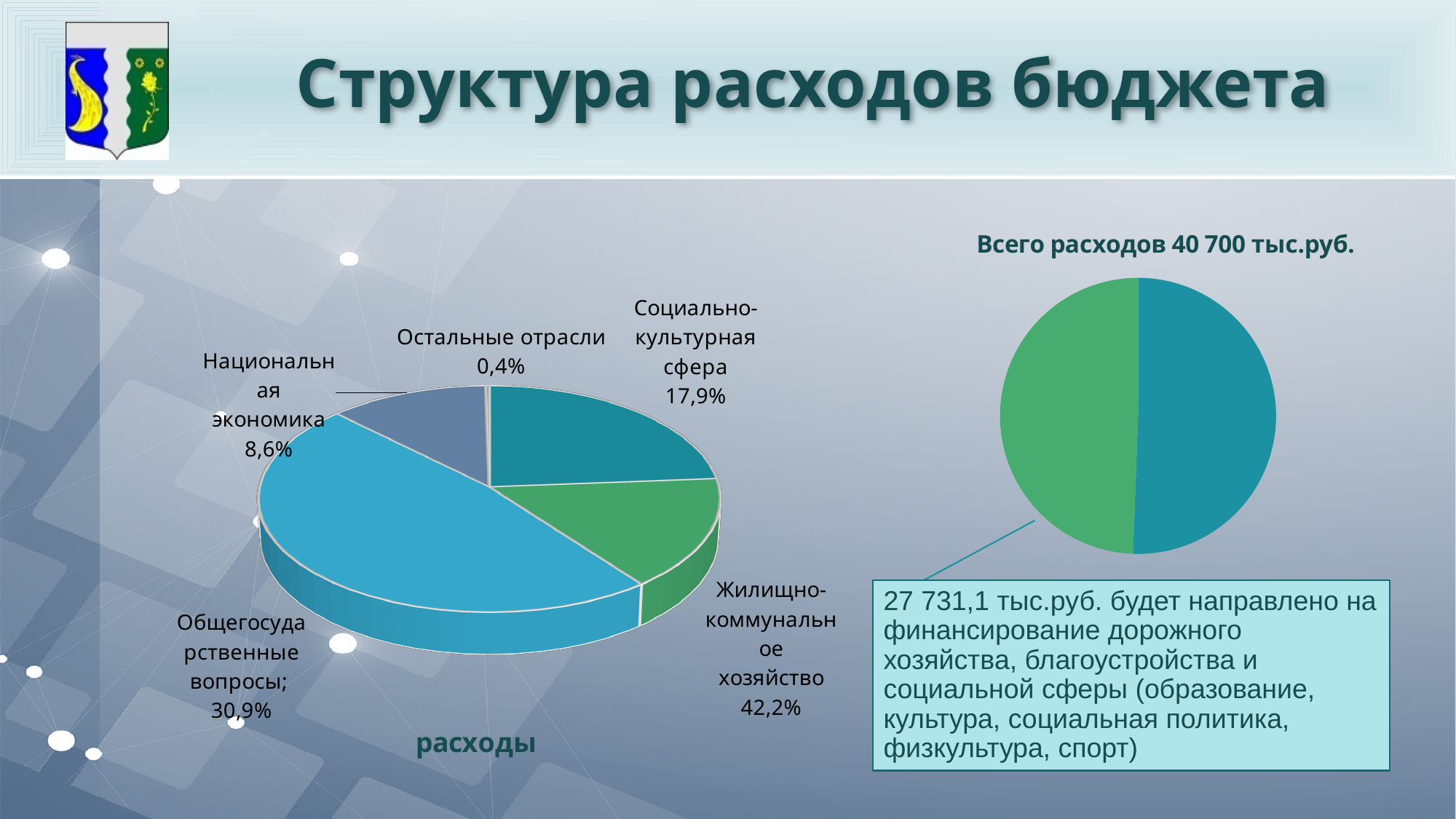
In the pie chart titled "расходы", which category has the smallest share? Остальные отрасли What kind of chart is the chart on the left of the slide? Pie chart How many categories are shown in the pie chart titled "расходы"? 5 In the pie chart titled "расходы", what share is labelled for Национальная экономика? 8,6% What is the title shown above the small pie chart on the right of the slide? Всего расходов 40 700 тыс.руб. In the pie chart titled "расходы", which is larger: Социально-культурная сфера or Национальная экономика? Социально-культурная сфера In the pie chart titled "расходы", what share is labelled for Жилищно-коммунальное хозяйство? 42,2% In the pie chart titled "расходы", what is the difference in percentage points between Жилищно-коммунальное хозяйство and Общегосударственные вопросы? 11,3 In the pie chart titled "расходы", what share is labelled for Остальные отрасли? 0,4% In the pie chart titled "расходы", what share is labelled for Социально-культурная сфера? 17,9% In the pie chart titled "расходы", what share is labelled for Общегосударственные вопросы? 30,9%